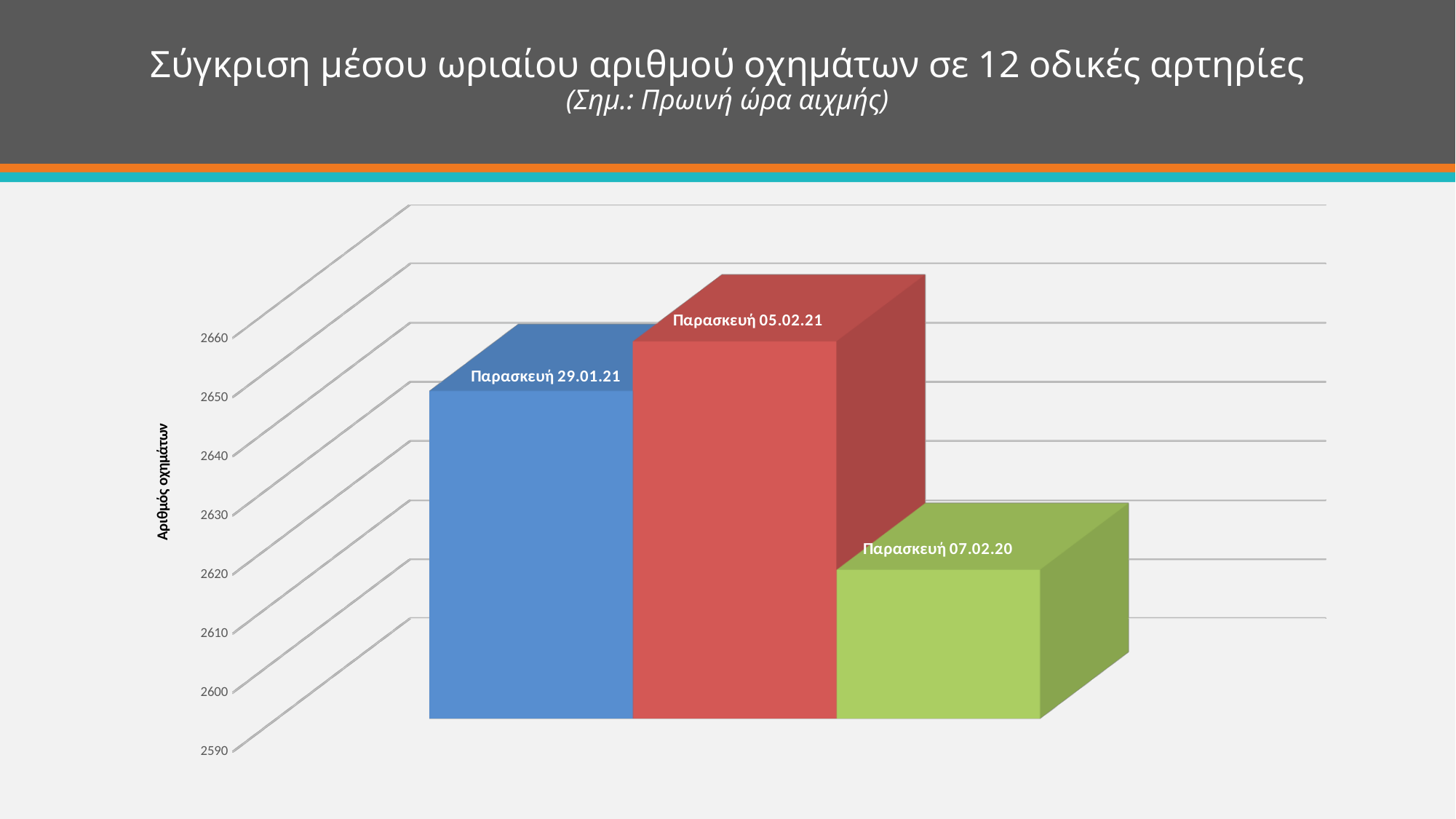
Is the value for Παρασκευή 29.01.21 greater or less than 2640? greater Is the value for Παρασκευή 07.02.20 greater or less than 2610? greater Is the value for Παρασκευή 07.02.20 greater or less than 2630? less Which category has the highest value? Παρασκευή 05.02.21 Does the value rise or fall from the first bar (Παρασκευή 29.01.21) to the second bar (Παρασκευή 05.02.21)? rise Which category has the lowest value? Παρασκευή 07.02.20 Which is larger, the value for Παρασκευή 29.01.21 or the value for Παρασκευή 07.02.20? Παρασκευή 29.01.21 Which is larger, the value for Παρασκευή 05.02.21 or the value for Παρασκευή 29.01.21? Παρασκευή 05.02.21 What is the title of the vertical axis? Αριθμός οχημάτων How many bars (categories) does the chart show? 3 What kind of chart is shown on the slide? bar chart